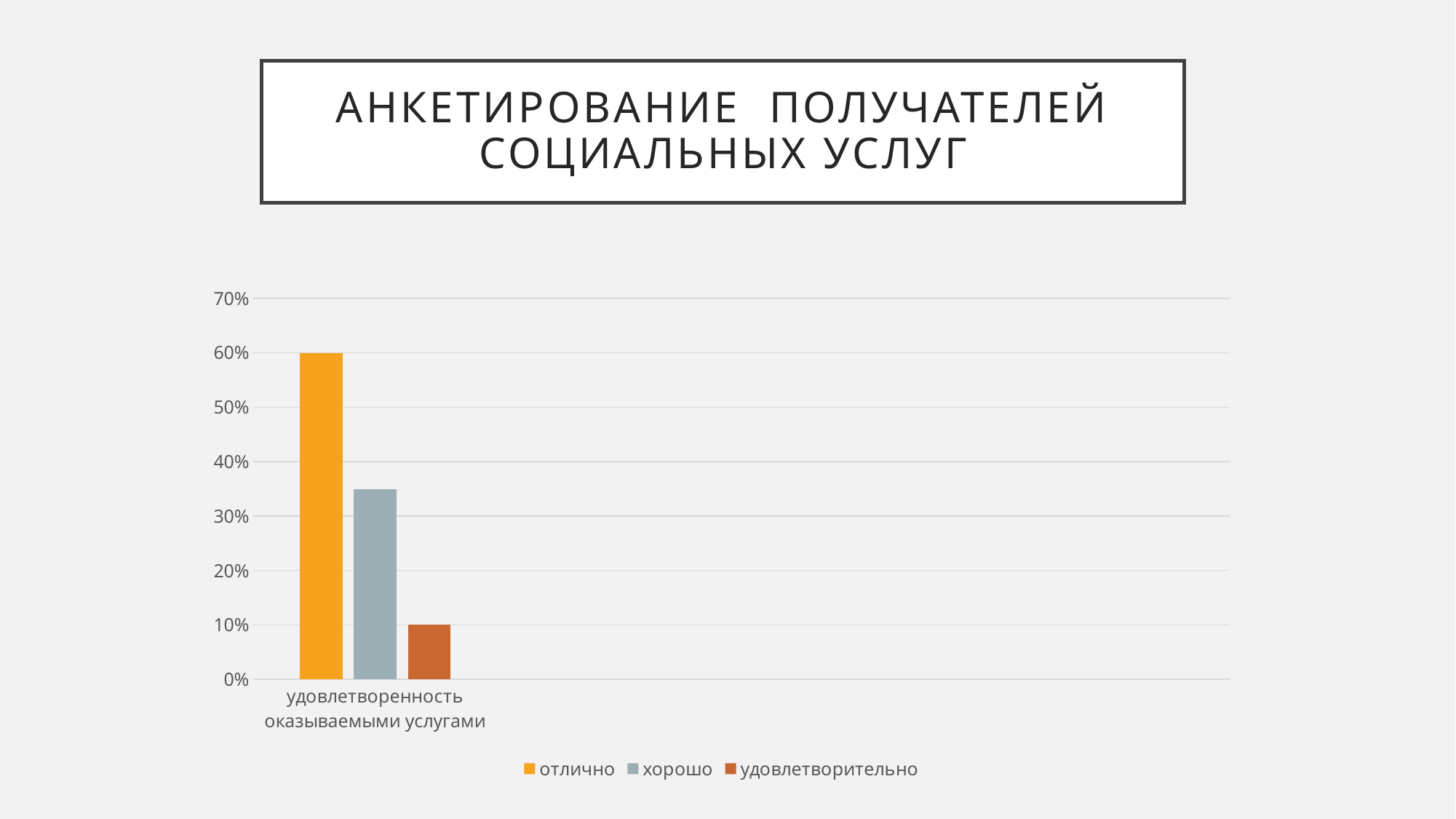
Is the value for "хорошо" greater or less than 30%? greater Which series has the lowest value? удовлетворительно How many series does the legend list? 3 What kind of chart is shown on the slide? bar chart What is the value for the series "удовлетворительно"? 10% Which series has the highest value? отлично What is the label of the category on the x axis? удовлетворенность оказываемыми услугами Which is larger, the value for "хорошо" or the value for "удовлетворительно"? хорошо What is the difference between the values for "отлично" and "удовлетворительно"? 50% How many categories are shown on the x axis? 1 Is the value for "хорошо" greater or less than 40%? less What is the value for the series "отлично"? 60%